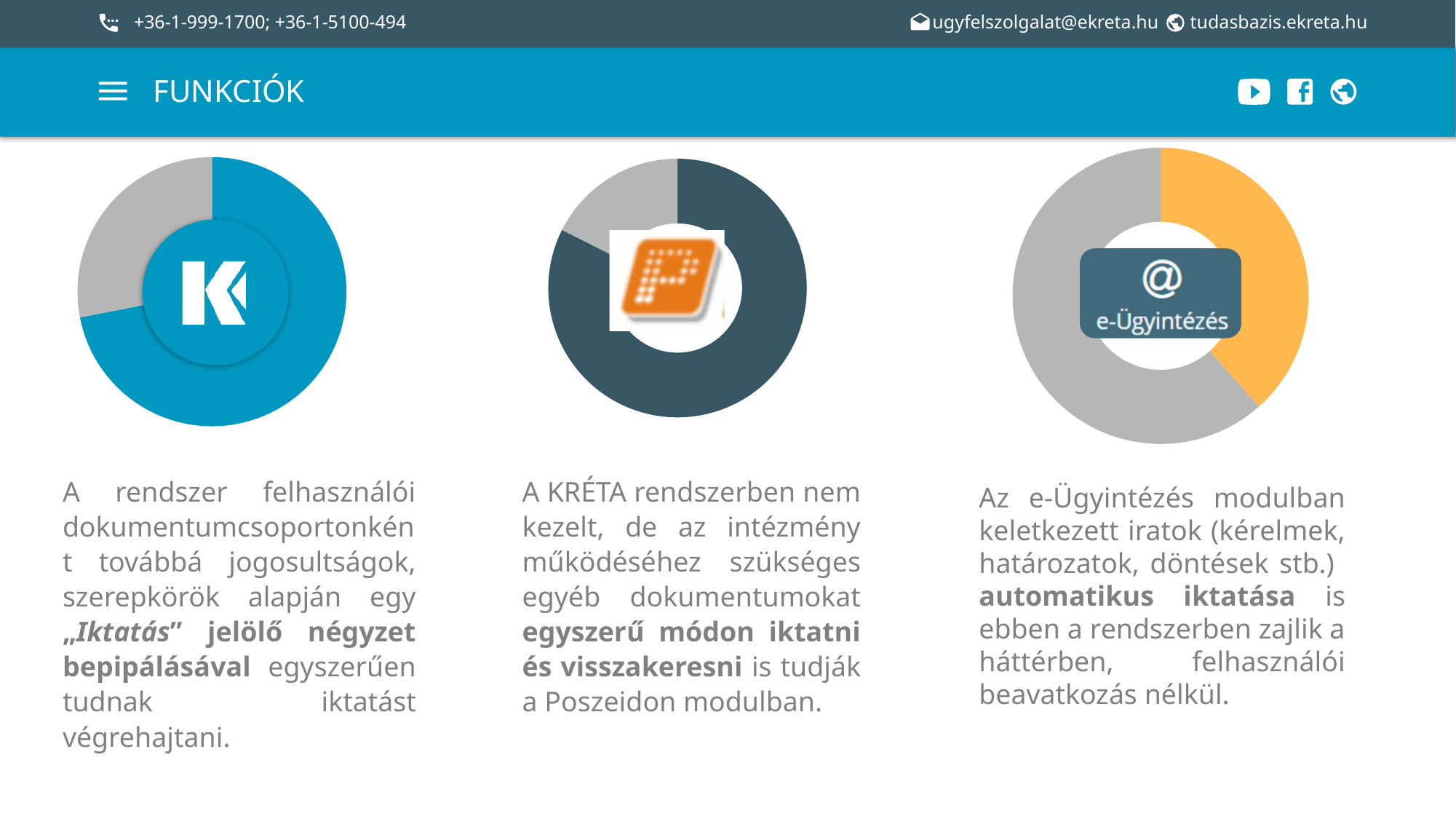
In the right chart (e-Ügyintézés), which slice is larger, the orange one or the grey one? the grey one What kind of chart is the middle chart on the slide (the one with the P logo)? doughnut chart What kind of chart is the left chart on the slide (the one with the K logo)? doughnut chart In the right chart (e-Ügyintézés), what colour is the smaller slice? orange In the middle chart (with the P logo), which slice is larger, the dark teal one or the grey one? the dark teal one What kind of chart is the right chart on the slide (the one labelled e-Ügyintézés)? doughnut chart How many slices does the left chart (with the K logo) have? 2 How many pie or doughnut charts are shown on the slide? 3 In the left chart (with the K logo), which slice is larger, the blue one or the grey one? the blue one How many slices does the middle chart (with the P logo) have? 2 How many slices does the right chart (e-Ügyintézés) have? 2